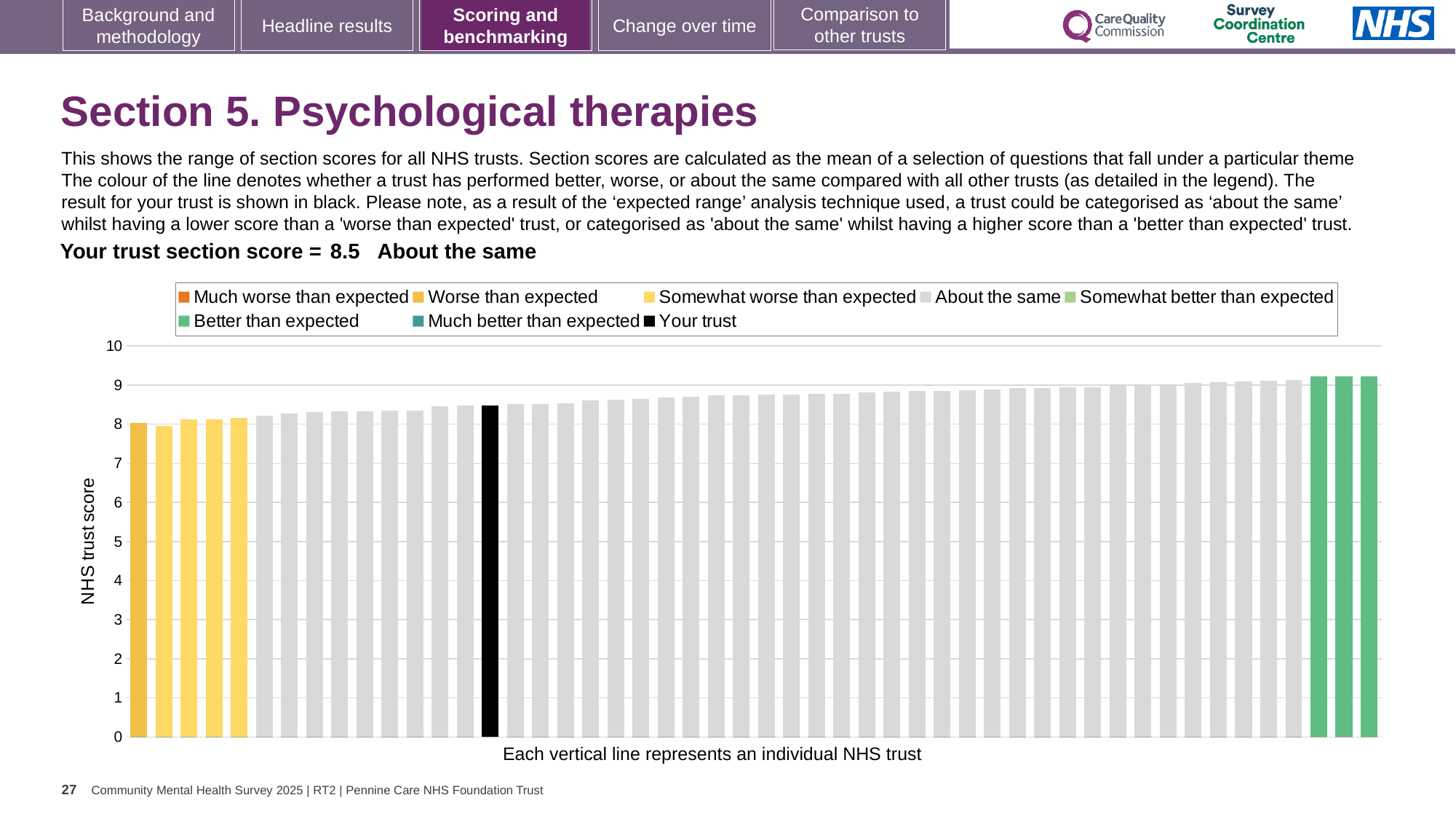
Is the value of the black 'Your trust' bar greater or less than 8? greater Is the value of the leftmost bar greater or less than 9? less What is the highest value shown on the vertical axis? 10 Which category is your trust placed in for this section? About the same How many entries does the chart legend list? 8 What is your trust's section score for Psychological therapies? 8.5 Are the green 'Better than expected' bars at the right of the chart greater or less than 9? greater Do the bar values rise or fall moving from left to right along the x axis? rise What kind of chart is shown on the slide? bar chart How many bars are coloured green (Better than expected)? 3 What is the label on the vertical axis of the chart? NHS trust score